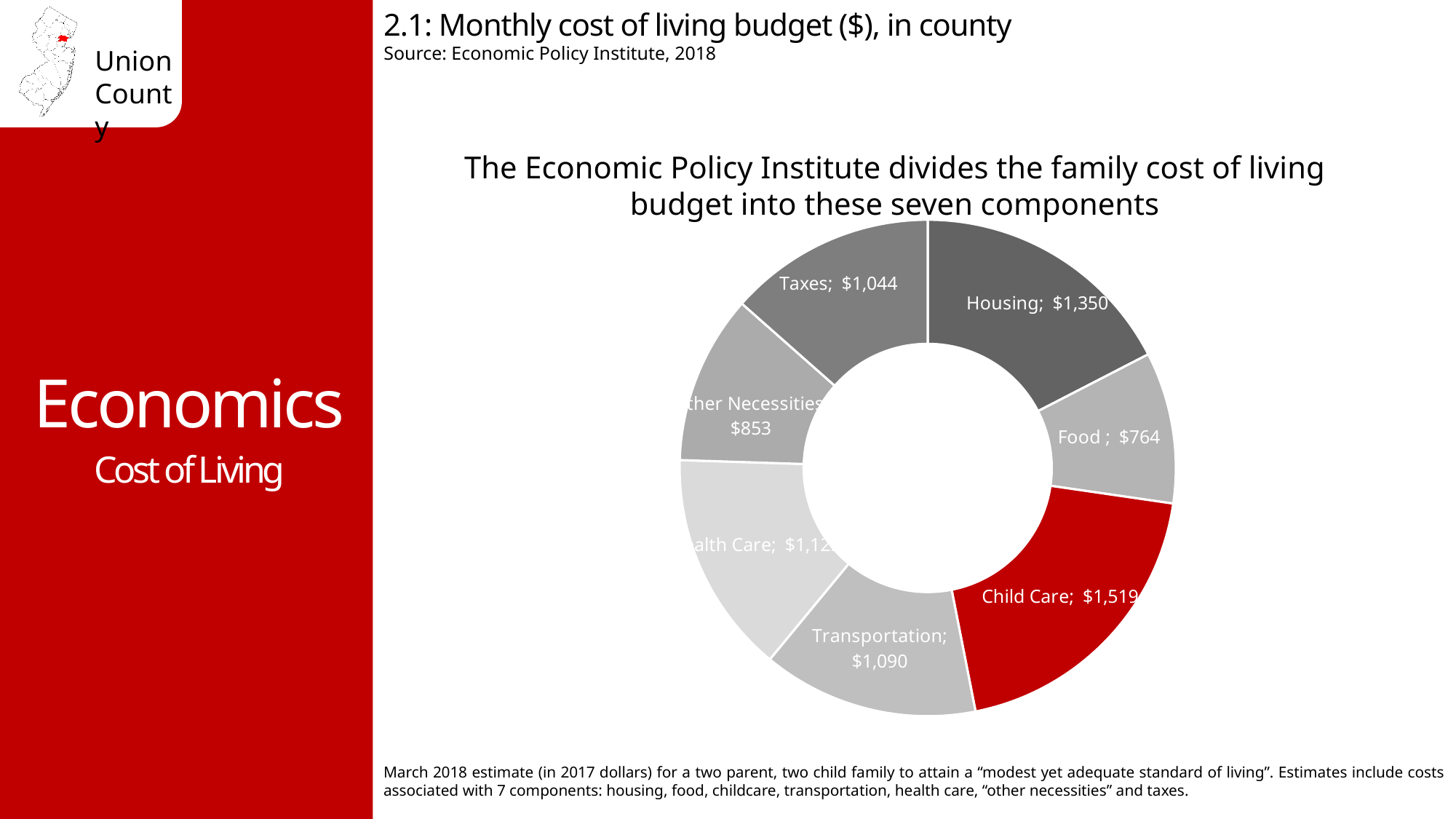
What is the monthly cost for Housing? $1,350 Which component has the highest monthly cost? Child Care What is the monthly cost for Taxes? $1,044 What is the difference between the Housing and Food monthly costs? $586 What is the monthly cost for Food? $764 What is the monthly cost for Transportation? $1,090 What type of chart is used to show the monthly cost of living budget? Doughnut (pie) chart How much more is the monthly cost of Child Care than Housing? $169 Which is larger, the monthly cost for Transportation or for Food? Transportation Which component has the lowest monthly cost? Food What is the monthly cost for Child Care? $1,519 How many components are shown in the chart? 7